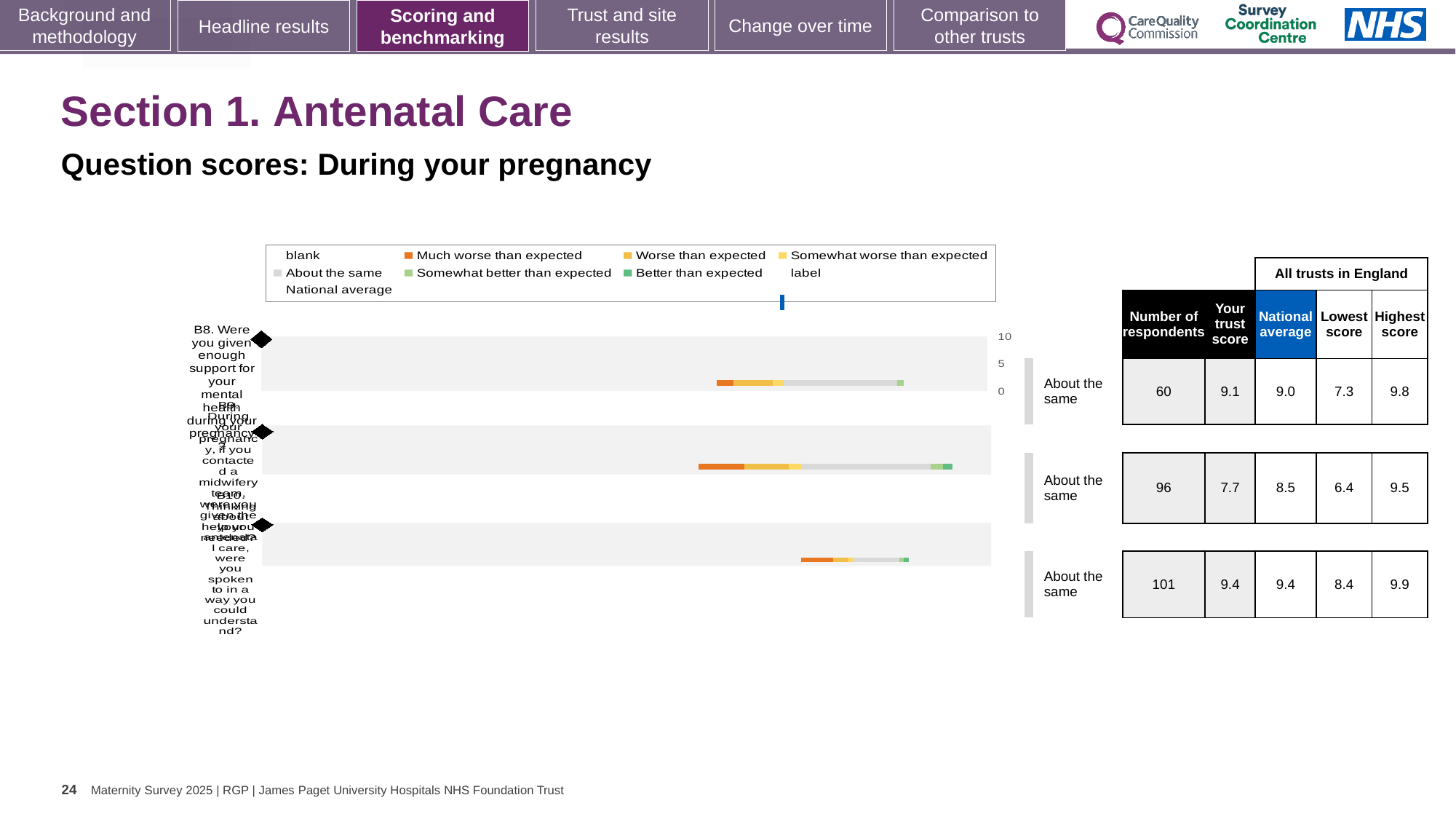
What is the Highest score among all trusts in England for the first row (B8)? 9.8 How many respondents are listed for the third row of the chart? 101 Which row has the lowest 'Your trust score'? the second row (7.7) What is the National average for the second row of the chart? 8.5 How many survey questions (bars) are plotted in the chart? 3 For the second row, what is the difference between the National average and the trust score? 0.8 What colour does the legend use for 'Much worse than expected'? orange For the first row (B8), which is larger: the trust score or the National average? the trust score (9.1) Which row has the highest 'Your trust score'? the third row (9.4) What benchmark label is shown next to each of the three bars? About the same What is the 'Your trust score' for the first row (B8, support for your mental health during pregnancy)? 9.1 What kind of chart is shown on the slide? bar chart